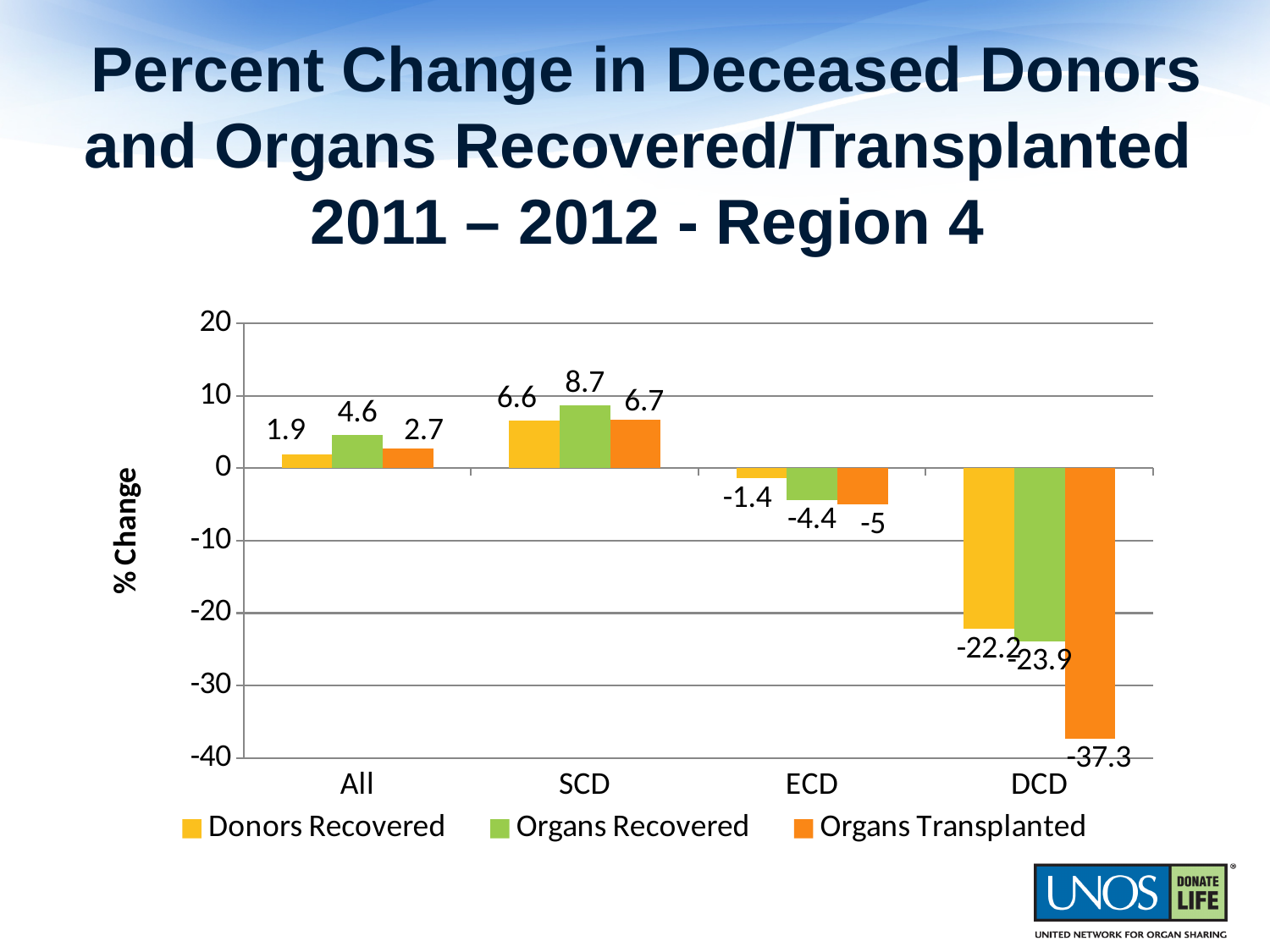
How many categories are shown on the x axis? 4 How many series does the legend list? 3 Which category has the lowest value for Organs Transplanted? DCD What kind of chart is shown on the slide? bar chart What is the difference between Organs Recovered and Donors Recovered in the All category? 2.7 Is the value for Organs Transplanted in the DCD category greater or less than -30? less Which category has the highest value for Organs Recovered? SCD What is the value for Donors Recovered in the ECD category? -1.4 What is the label of the y axis? % Change Which is larger in the SCD category, Donors Recovered or Organs Transplanted? Organs Transplanted What is the value for Organs Transplanted in the DCD category? -37.3 What is the value for Organs Recovered in the SCD category? 8.7